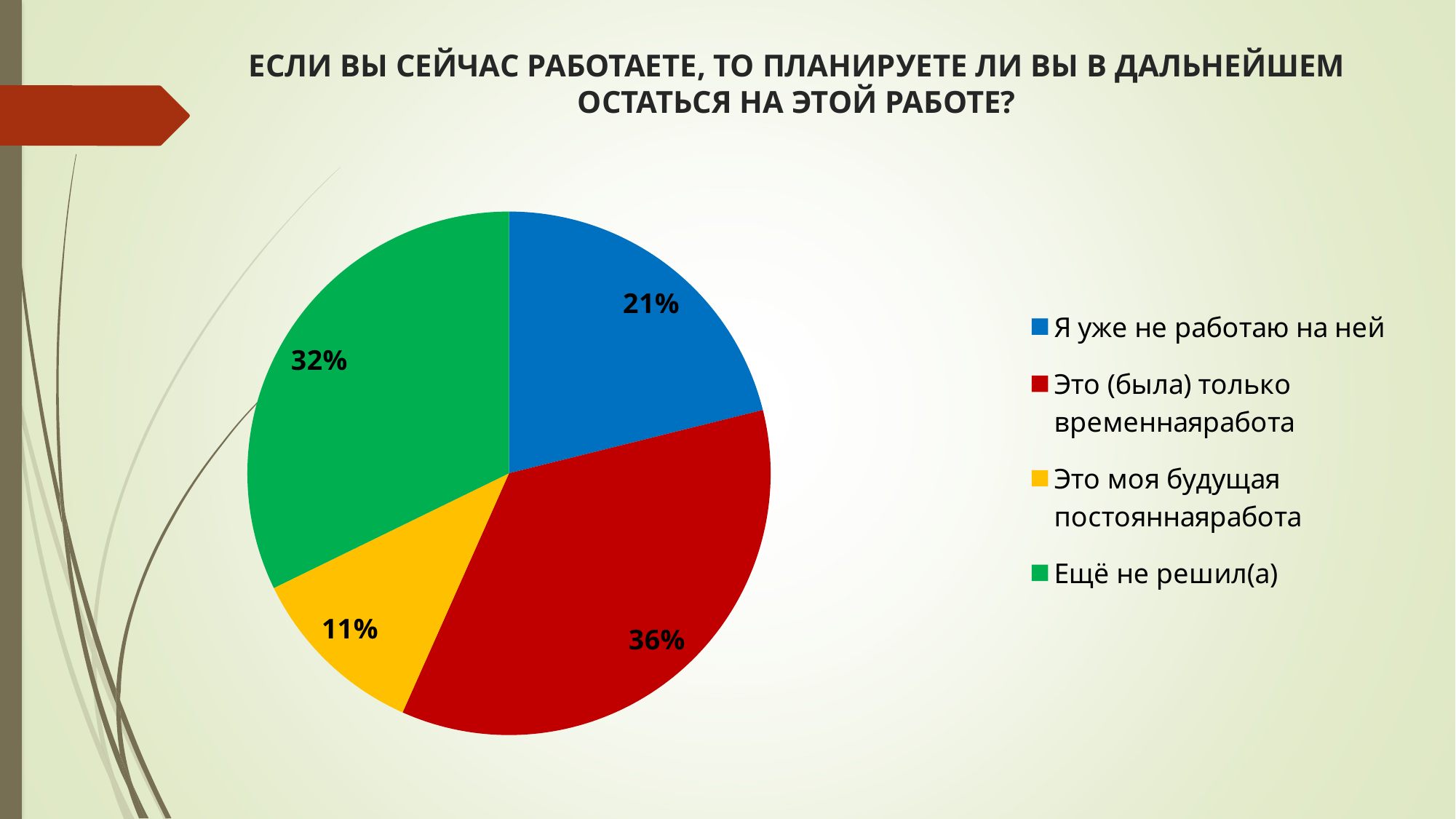
Which is larger: the slice for "Ещё не решил(а)" or the slice for "Я уже не работаю на ней"? Ещё не решил(а) What share of the pie does "Это (была) только временнаяработа" have? 36% What share of the pie does "Ещё не решил(а)" have? 32% What kind of chart is shown on the slide? pie chart What is the difference in percentage points between "Это (была) только временнаяработа" and "Ещё не решил(а)"? 4 What share of the pie does "Это моя будущая постояннаяработа" have? 11% What is the difference in percentage points between "Я уже не работаю на ней" and "Это моя будущая постояннаяработа"? 10 Which category has the largest slice of the pie? Это (была) только временнаяработа Which category has the smallest slice of the pie? Это моя будущая постояннаяработа What colour is the slice for "Ещё не решил(а)"? green How many slices does the pie chart have? 4